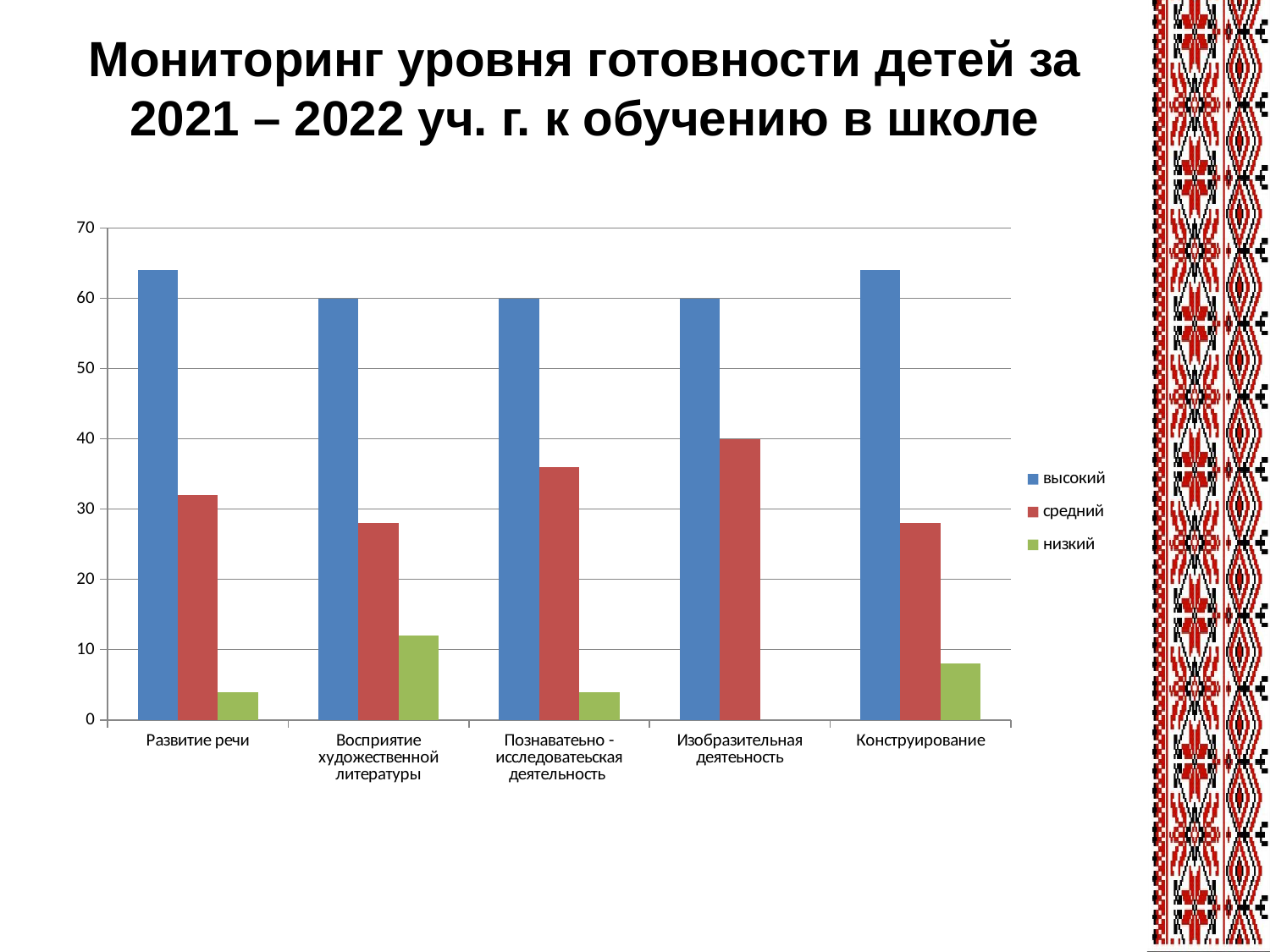
Is the value of the высокий series for Развитие речи greater or less than 60? greater What kind of chart is shown on the slide? bar chart How many categories are shown on the x axis? 5 Which category has the highest value for the низкий series? Восприятие художественной литературы Which is larger for Познавательно-исследовательская деятельность: the высокий value or the средний value? высокий What is the value of the высокий series for Изобразительная деятельность? 60 Is the value of the низкий series for Восприятие художественной литературы greater or less than 10? greater How many series does the legend list? 3 What is the value of the средний series for Изобразительная деятельность? 40 What are the three series listed in the legend? высокий, средний, низкий Is the value of the средний series for Развитие речи greater or less than 30? greater Which category has the highest value for the средний series? Изобразительная деятельность